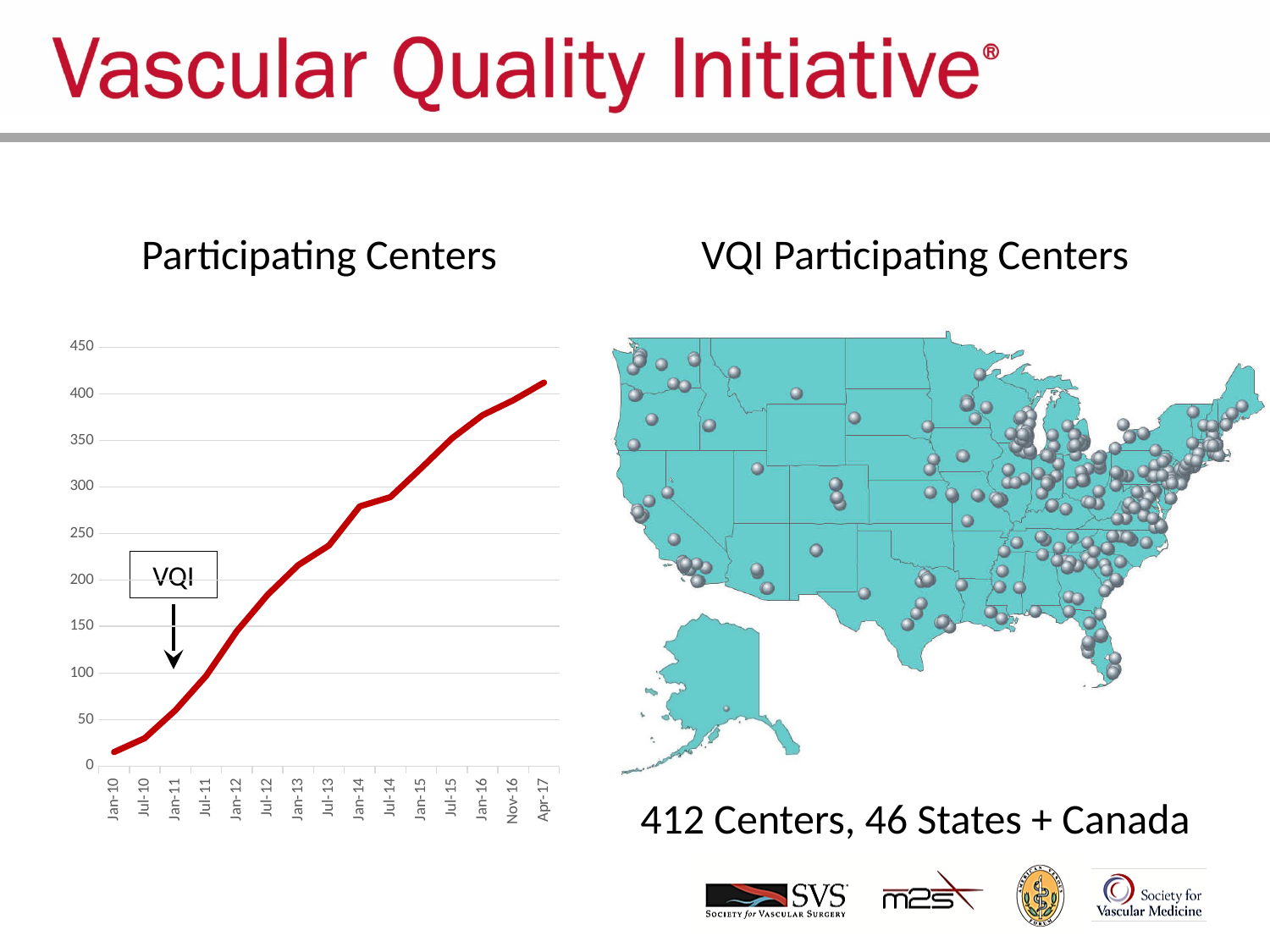
In the 'Participating Centers' chart, do the values rise or fall from Jan-10 to Apr-17? rise In the 'Participating Centers' chart, which x-axis point has the highest value? Apr-17 In the 'Participating Centers' chart, which is larger, the value for Jan-14 or the value for Jul-12? Jan-14 In the 'Participating Centers' chart, is the value for Jan-10 greater or less than 50? less In the 'Participating Centers' chart, which x-axis point has the lowest value? Jan-10 In the 'Participating Centers' chart, is the value for Jul-11 greater or less than 150? less In the 'Participating Centers' chart, is the value for Jan-14 greater or less than 250? greater What kind of chart is the 'Participating Centers' chart? line chart What colour is the line in the 'Participating Centers' chart? red